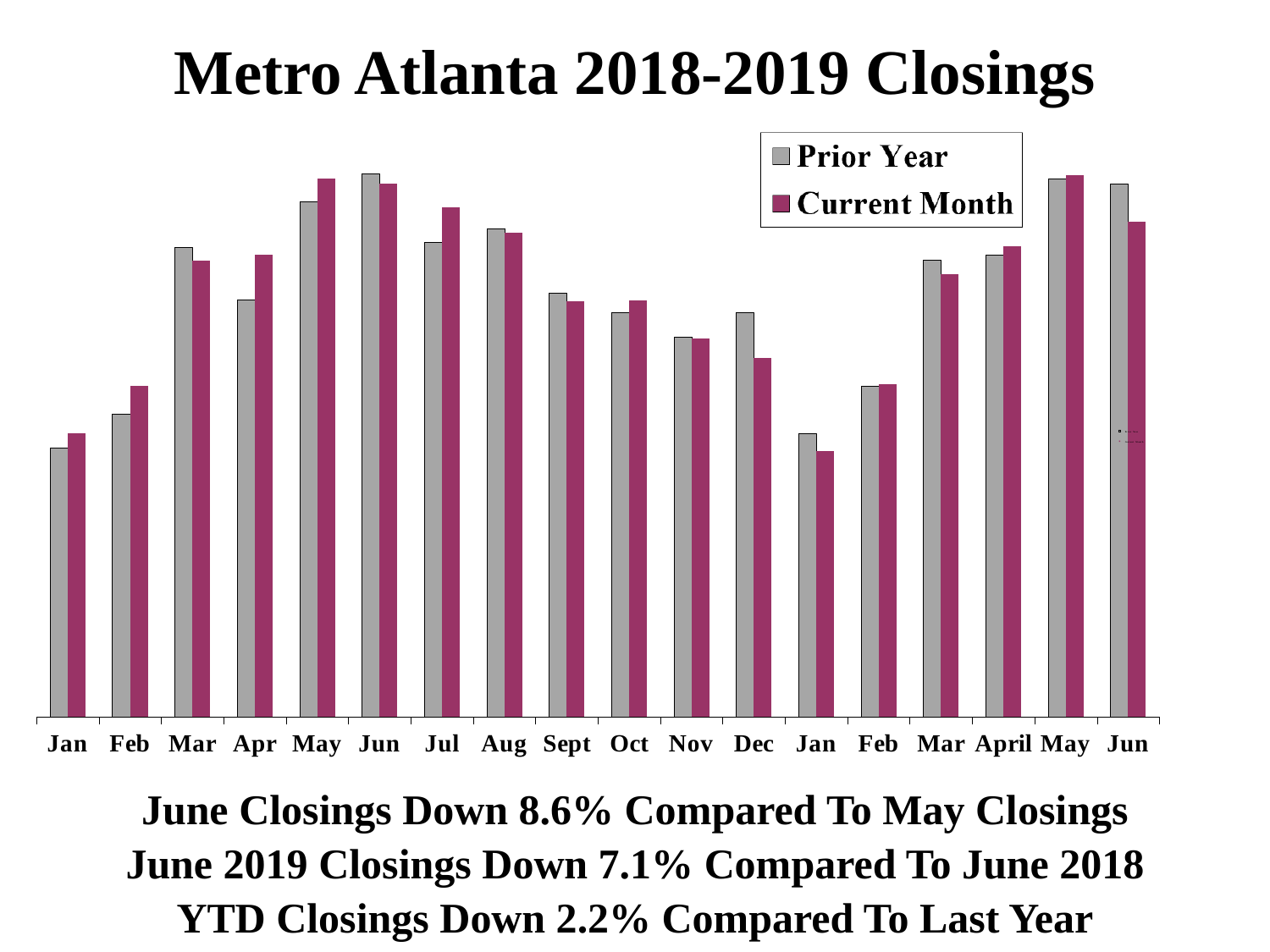
For the last Jun on the x axis, which is larger: Prior Year or Current Month? Prior Year For the first Apr on the x axis, which is larger: Prior Year or Current Month? Current Month For the first Jan on the x axis, which is larger: Prior Year or Current Month? Current Month Which month has the lowest Prior Year value? Jan (first) Which series is shown in the darker magenta bars? Current Month Which month has the lowest Current Month value? Jan (second) How many series does the legend list? 2 Do the Current Month values generally rise or fall from the second Jan to the second May on the x axis? rise What kind of chart is shown on the slide? bar chart What is the title of the chart? Metro Atlanta 2018-2019 Closings How many month categories are shown along the x axis? 18